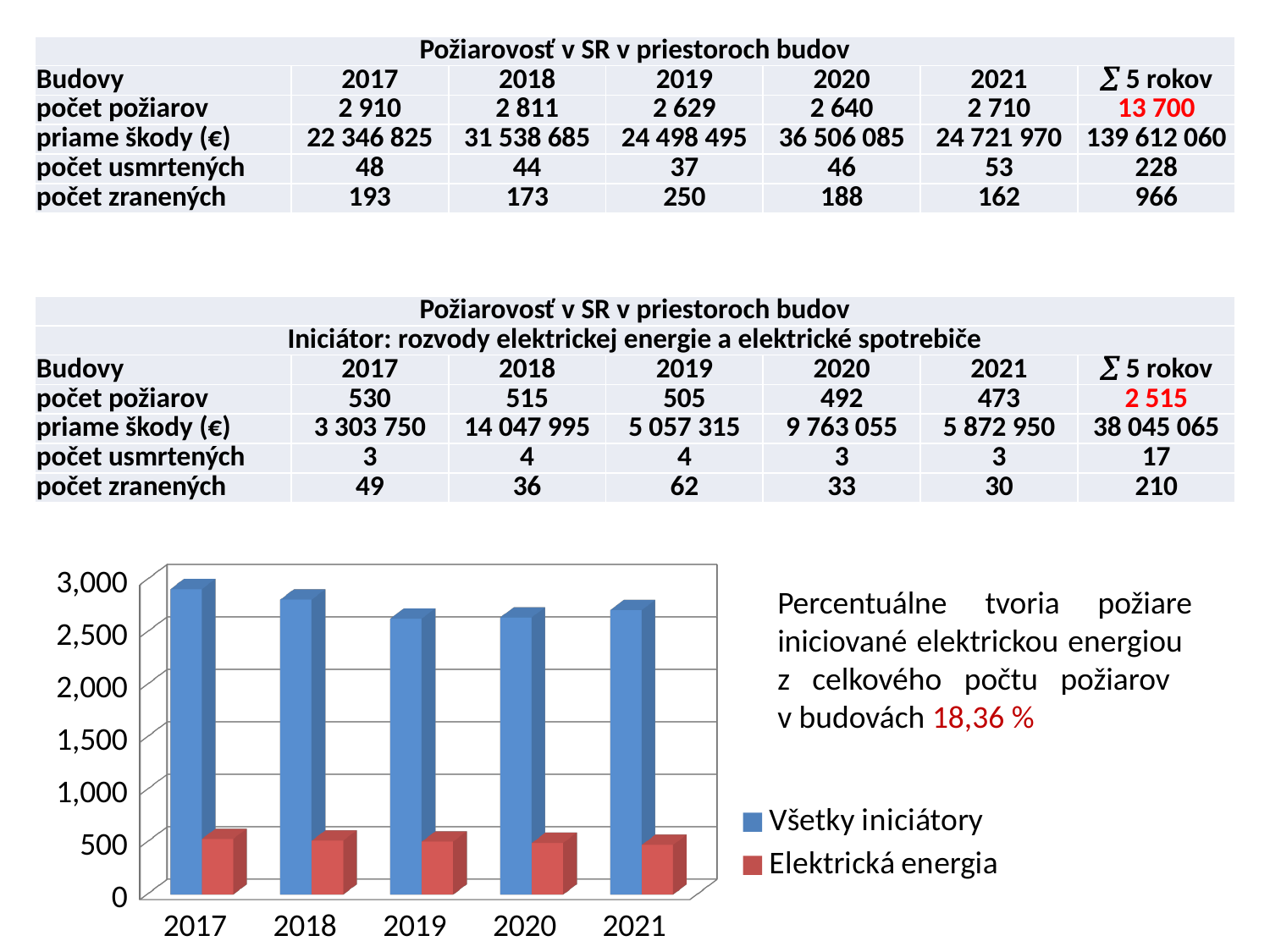
How many years are shown on the x axis of the chart? 5 In 2020, which series has the larger value: Všetky iniciátory or Elektrická energia? Všetky iniciátory Is the value for Všetky iniciátory in 2017 greater or less than 2,500? greater Which is larger in the chart: Všetky iniciátory in 2017 or Všetky iniciátory in 2021? 2017 Is the value for Všetky iniciátory in 2019 greater or less than 2,000? greater Which colour represents Elektrická energia in the chart? red What kind of chart is shown at the bottom of the slide? bar chart Is the value for Elektrická energia in 2019 greater or less than 1,000? less Which year has the highest value for Všetky iniciátory in the chart? 2017 What are the two legend entries of the chart? Všetky iniciátory, Elektrická energia How many series does the chart's legend list? 2 Do the values for Elektrická energia rise or fall from 2017 to 2021? fall